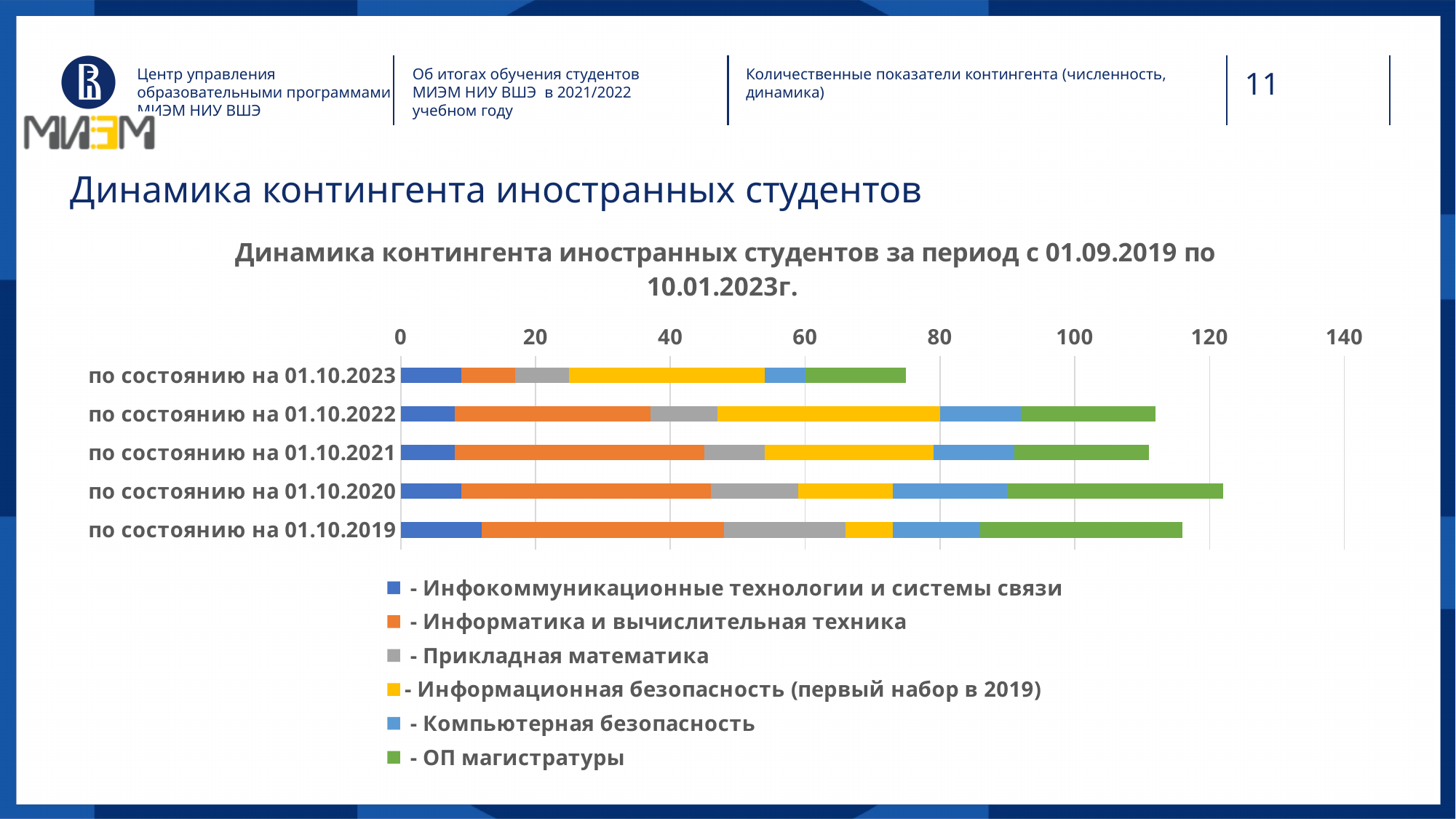
What kind of chart is shown on the slide? bar chart How many categories (dates) are plotted on the chart? 5 Is the total for по состоянию на 01.10.2023 greater or less than 80? less Which date has the lowest total number of foreign students? по состоянию на 01.10.2023 What is the title of the chart? Динамика контингента иностранных студентов за период с 01.09.2019 по 10.01.2023г. Which colour represents the series ОП магистратуры in the legend? green Which has a larger total: по состоянию на 01.10.2022 or по состоянию на 01.10.2023? по состоянию на 01.10.2022 How many series does the legend list? 6 Is the total for по состоянию на 01.10.2023 greater or less than 60? greater Which date has the highest total number of foreign students? по состоянию на 01.10.2020 Is the total for по состоянию на 01.10.2022 greater or less than 100? greater